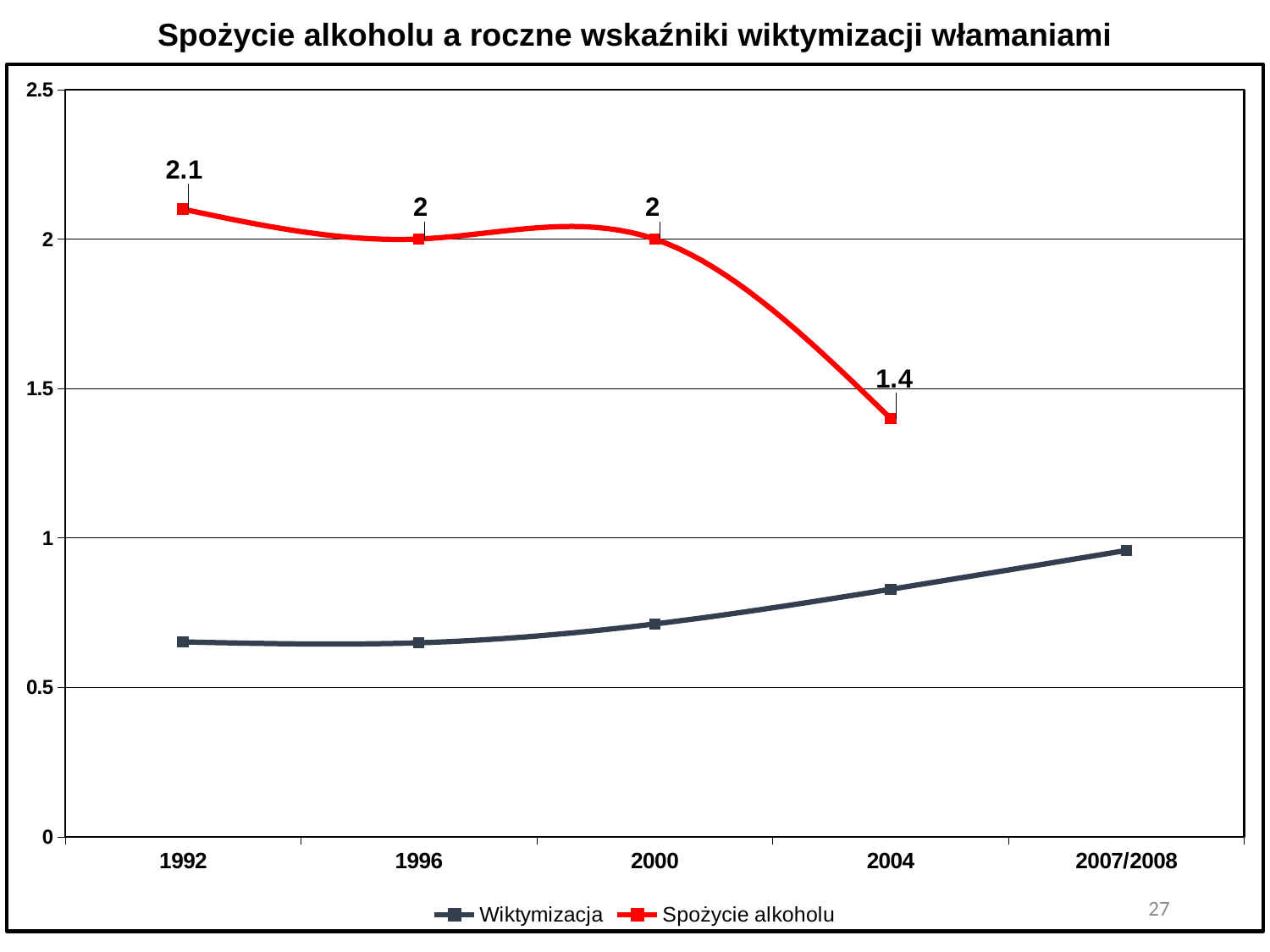
What is the value of Spożycie alkoholu in 1992? 2.1 Is the value for Wiktymizacja in 1992 greater or less than 0.5? greater Does the Wiktymizacja series rise or fall from 1992 to 2007/2008? rise In which year is Spożycie alkoholu highest? 1992 How many series does the legend list? 2 What kind of chart is this? line chart What is the difference between Spożycie alkoholu in 1992 and in 2004? 0.7 How many categories are shown on the x axis? 5 In which year is Spożycie alkoholu lowest? 2004 Which is larger for Spożycie alkoholu: the value in 1996 or the value in 2004? 1996 Is the value for Wiktymizacja in 2007/2008 greater or less than 1? less What is the value of Spożycie alkoholu in 2004? 1.4